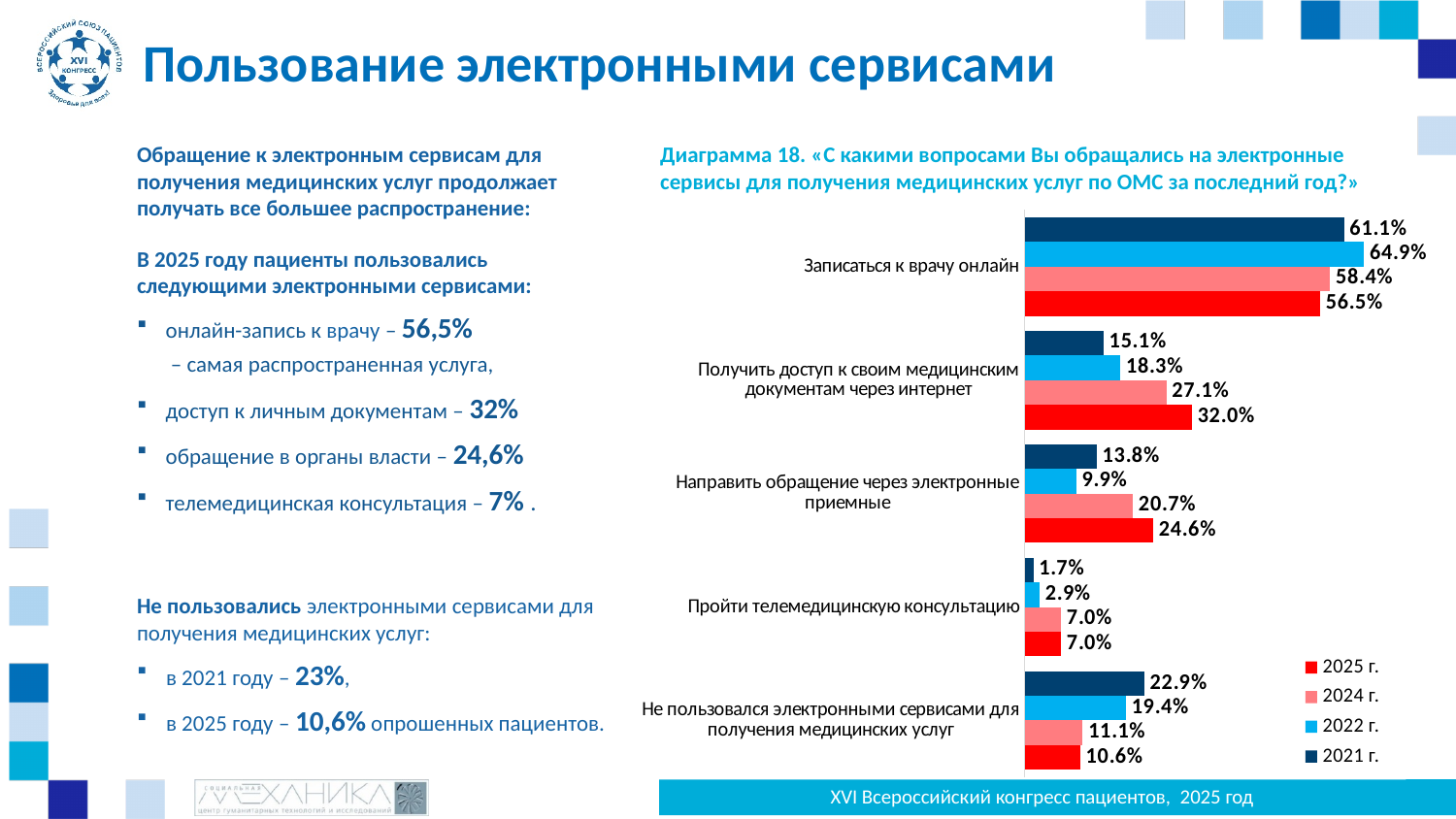
How does the value for 'Не пользовался электронными сервисами для получения медицинских услуг' change from 2021 г. to 2025 г.? It falls What is the difference between the 2025 г. and 2021 г. values for 'Направить обращение через электронные приемные'? 10.8% Which is larger for 'Записаться к врачу онлайн': the 2022 г. value or the 2024 г. value? 2022 г. What is the value for 'Записаться к врачу онлайн' in 2025 г.? 56.5% What type of chart is shown on the slide? bar chart Which colour represents 2025 г. in the chart legend? red Which category has the highest value in 2025 г.? Записаться к врачу онлайн How many categories are shown on the chart? 5 What is the value for 'Получить доступ к своим медицинским документам через интернет' in 2021 г.? 15.1% What is the value for 'Не пользовался электронными сервисами для получения медицинских услуг' in 2022 г.? 19.4% Which category has the lowest value in 2021 г.? Пройти телемедицинскую консультацию How many series does the chart legend list? 4